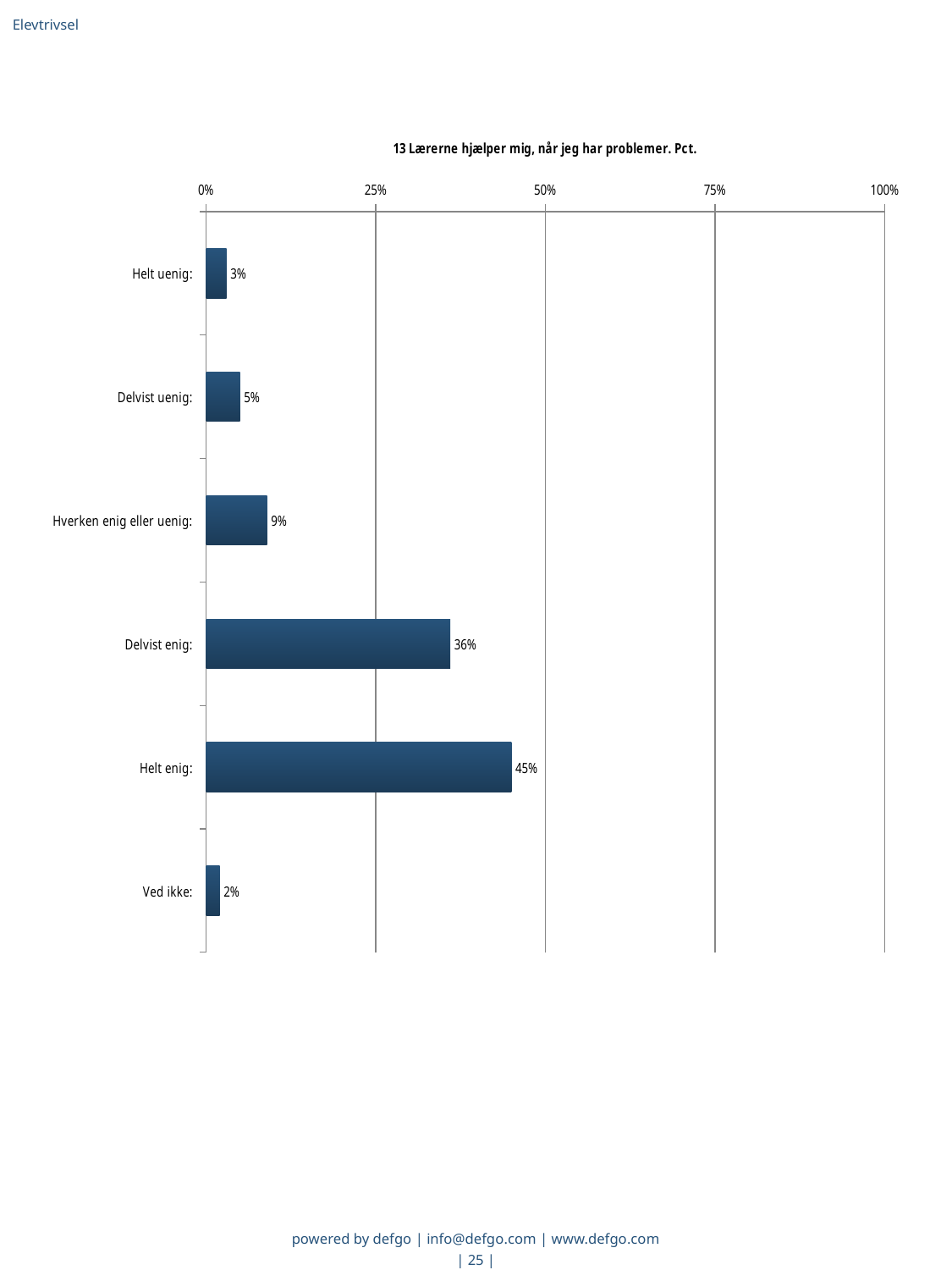
Is the value for "Delvist enig" greater or less than 25%? greater Which category has the highest value? Helt enig What kind of chart is shown on the slide? Bar chart What is the value for "Ved ikke"? 2% What is the value for "Hverken enig eller uenig"? 9% What is the difference between the values for "Helt enig" and "Delvist enig"? 9% What is the title of the chart? 13 Lærerne hjælper mig, når jeg har problemer. Pct. Which category has the lowest value? Ved ikke What is the value for "Helt enig"? 45% How many categories are shown in the chart? 6 Which is larger, the value for "Delvist uenig" or the value for "Hverken enig eller uenig"? Hverken enig eller uenig What is the value for "Delvist enig"? 36%